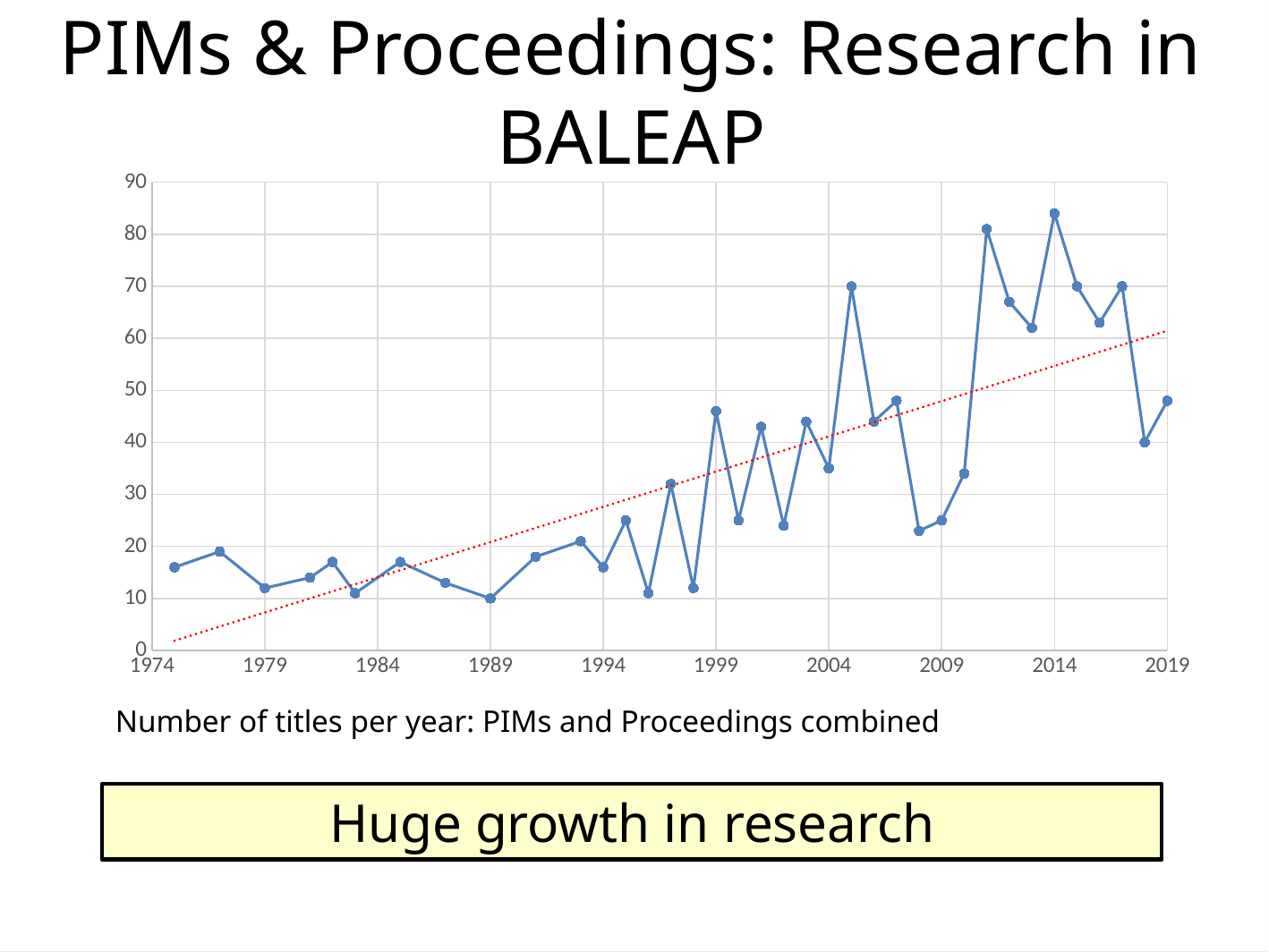
In which year does the line reach its highest value? 2014 Is the value for 1999 greater or less than 40? greater What kind of chart is shown on the slide? line chart Which year has the larger value, 1989 or 1999? 1999 Is the value for 1996 greater or less than 20? less Overall, do the values rise or fall from 1974 to 2019? rise Which year has the larger value, 2011 or 2005? 2011 Is the value for 2009 greater or less than 30? less What does the caption below the chart say the values represent? Number of titles per year: PIMs and Proceedings combined